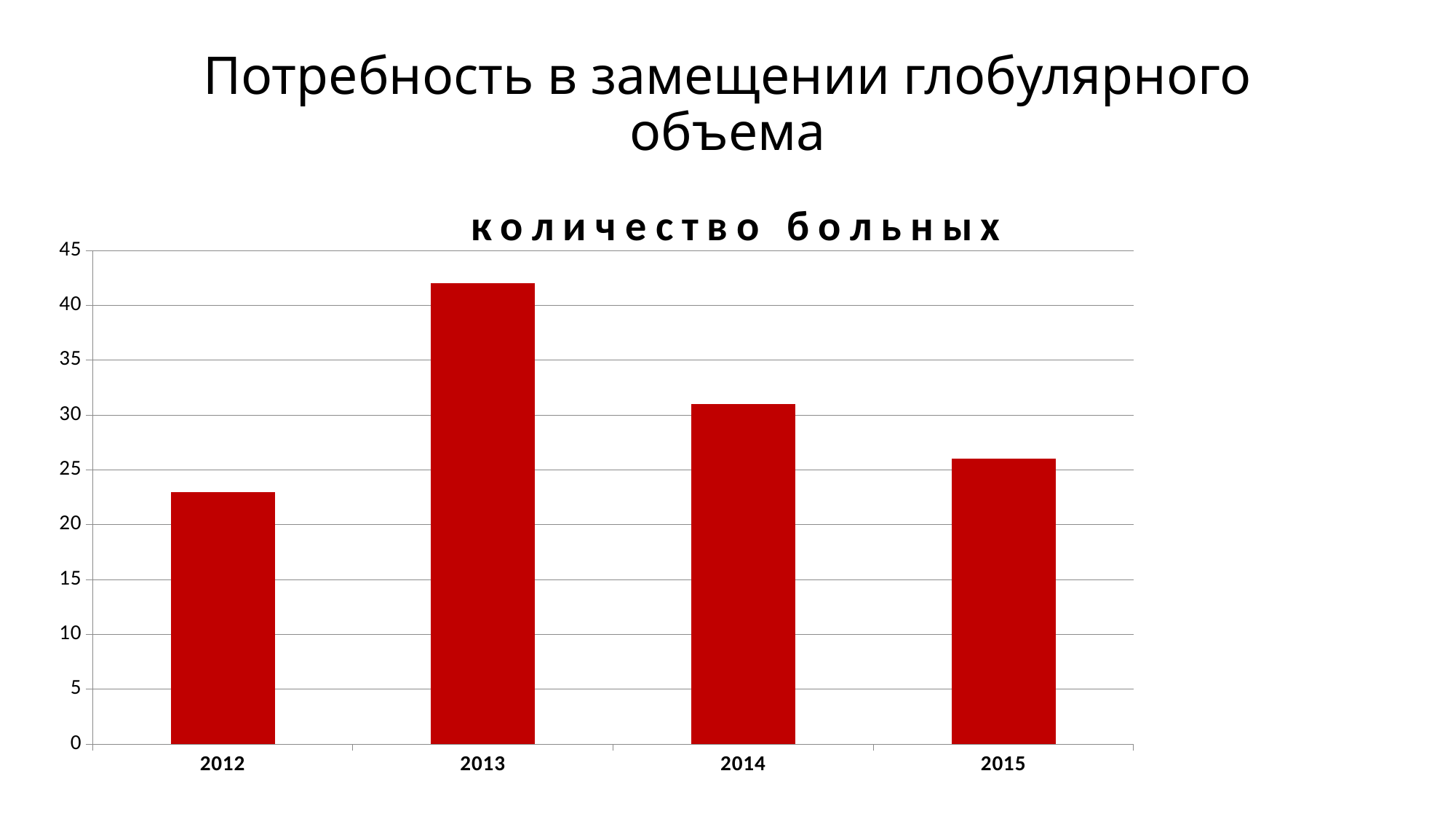
Which year has the highest number of patients (количество больных)? 2013 Is the value for 2015 greater or less than 30? less How many years are shown on the x axis of the chart? 4 Which year has a larger value, 2014 or 2015? 2014 What is the title of the chart? количество больных What kind of chart is shown on the slide? bar chart Is the value for 2013 greater or less than 40? greater Which year has a larger value, 2012 or 2013? 2013 Which year has the lowest number of patients (количество больных)? 2012 Is the value for 2014 greater or less than 30? greater Do the values rise or fall from 2013 to 2015? fall